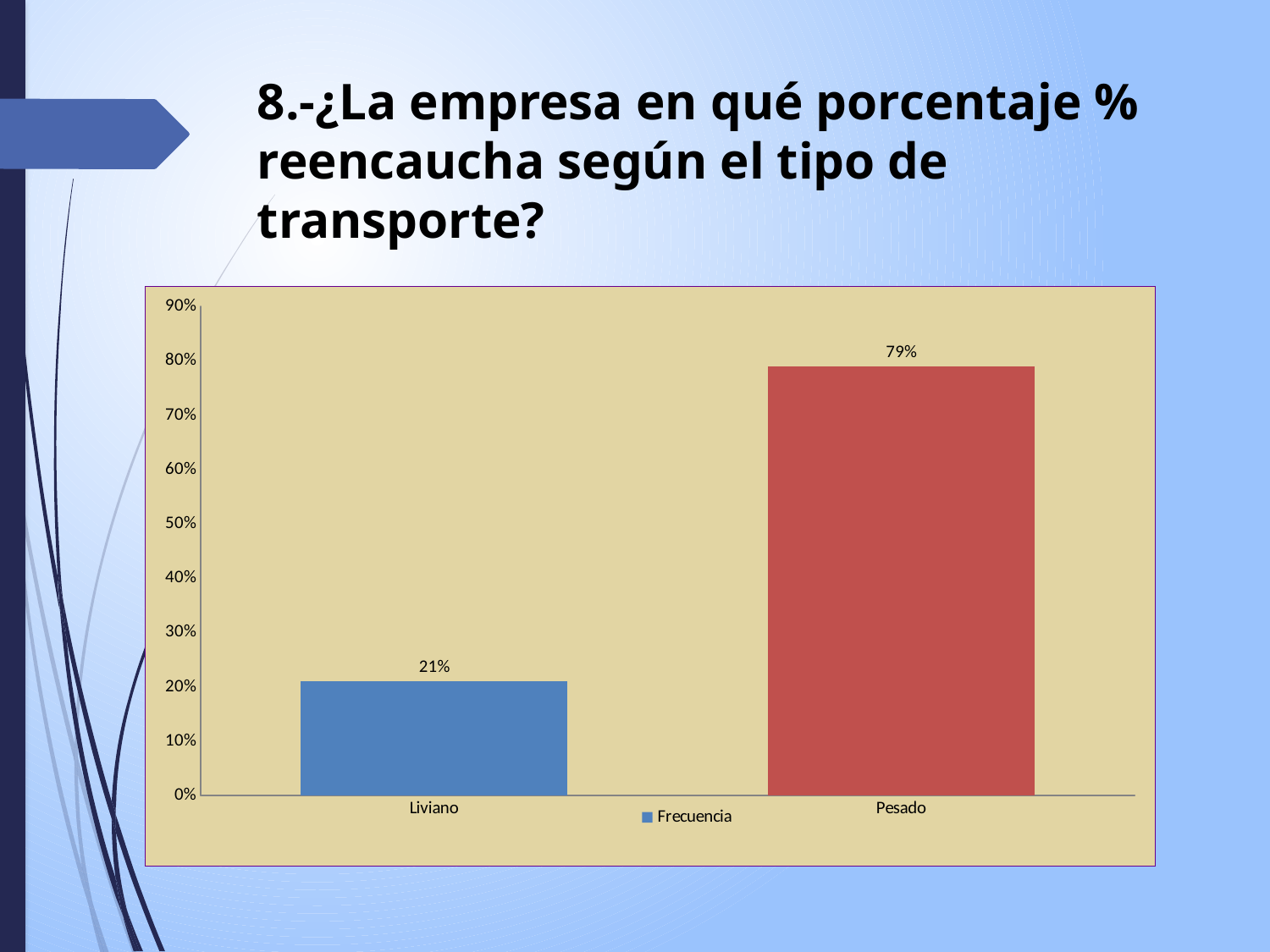
What is the name of the series listed in the legend? Frecuencia Is the value for Pesado greater or less than 70%? greater What kind of chart is shown on the slide? Bar chart What is the difference between the values for Pesado and Liviano? 58% What is the value for Liviano? 21% Which is larger, the value for Liviano or the value for Pesado? Pesado Which category has the lowest value? Liviano Is the value for Liviano greater or less than 30%? less How many series does the legend list? 1 Which category has the highest value? Pesado What is the value for Pesado? 79% How many categories are shown on the x axis? 2